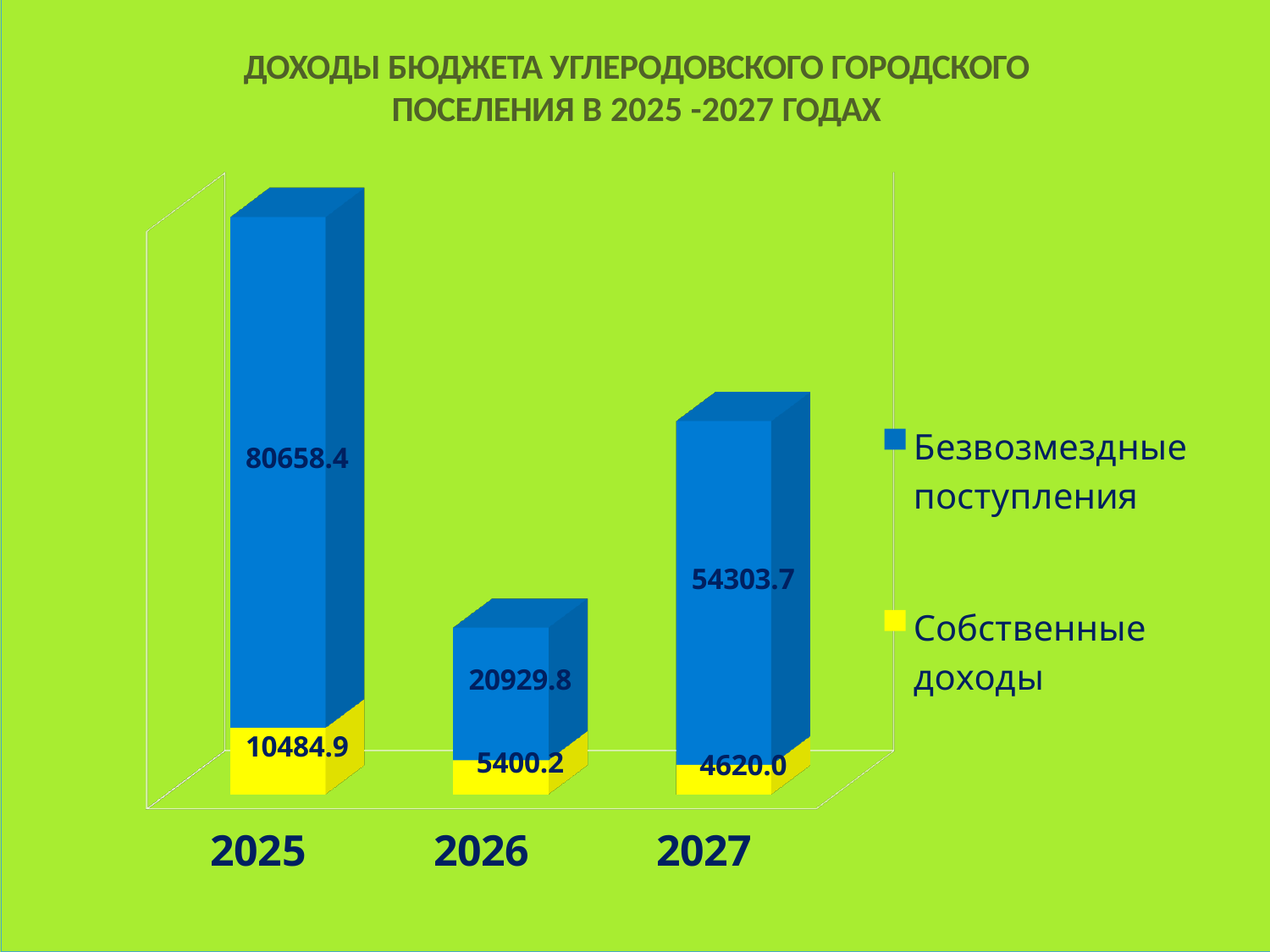
What is the total of the stacked bar for 2026? 26330.0 What is the total of the stacked bar for 2027? 58923.7 What is the difference between Безвозмездные поступления in 2025 and 2027? 26354.7 Which is larger: Безвозмездные поступления in 2026 or in 2027? 2027 What is the value of Безвозмездные поступления for 2027? 54303.7 Which year has the highest value of Безвозмездные поступления? 2025 How many series does the legend list? 2 How many years are shown on the x axis? 3 What is the difference between Собственные доходы in 2025 and 2026? 5084.7 What is the value of Собственные доходы for 2026? 5400.2 Which year has the lowest value of Собственные доходы? 2027 What is the value of Безвозмездные поступления for 2025? 80658.4